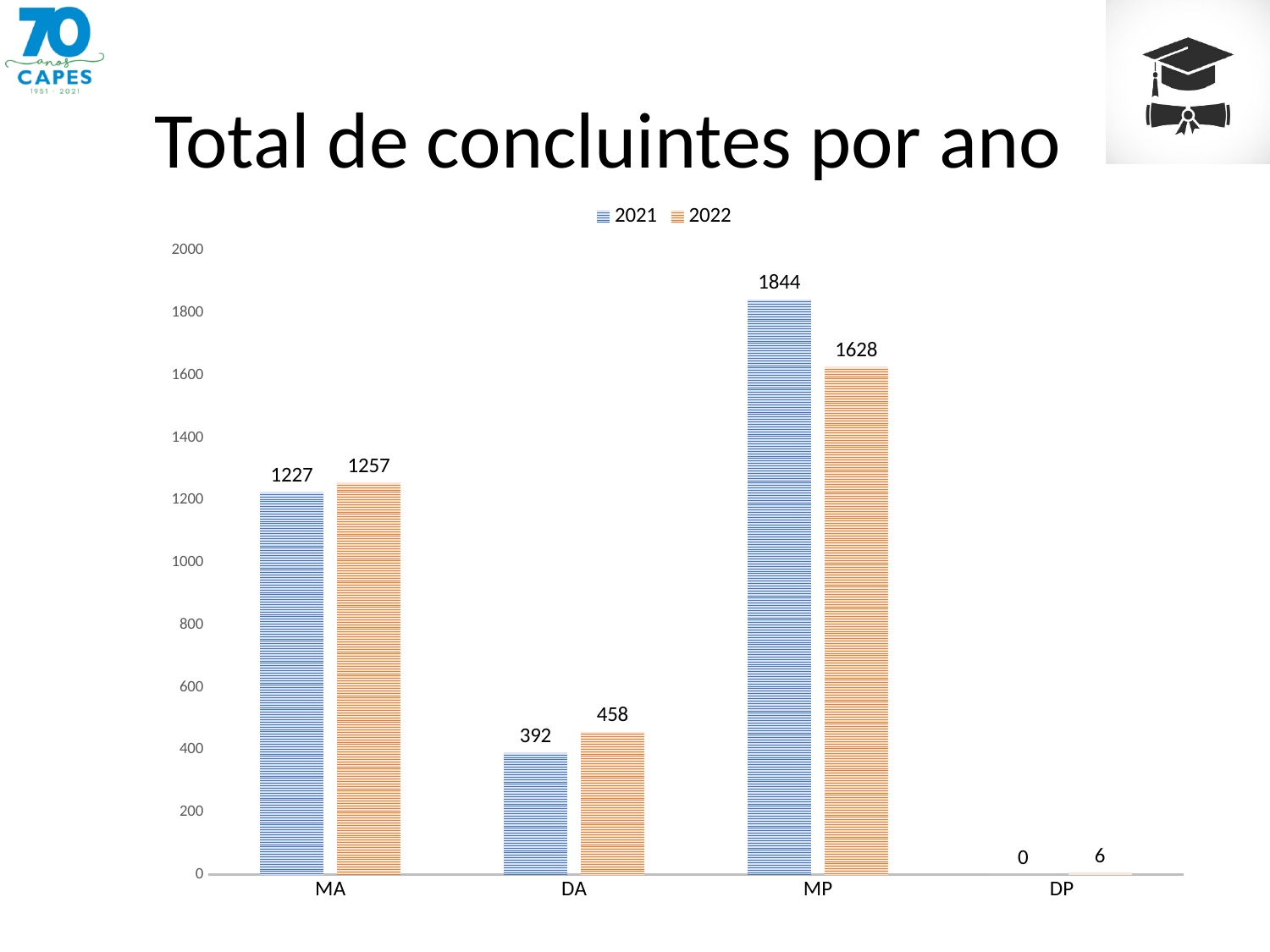
Which category has the highest value in 2021? MP How many categories are shown on the x axis? 4 What is the difference between the 2022 and 2021 values for DA? 66 What is the title of the chart? Total de concluintes por ano What is the value for DP in 2022? 6 What is the value for MA in 2021? 1227 Which category has the lowest value in 2022? DP What is the value for MP in 2022? 1628 Which is larger for MA: the 2021 value or the 2022 value? 2022 How many series does the legend list? 2 What is the difference between the 2021 and 2022 values for MP? 216 What kind of chart is shown on the slide? Bar chart